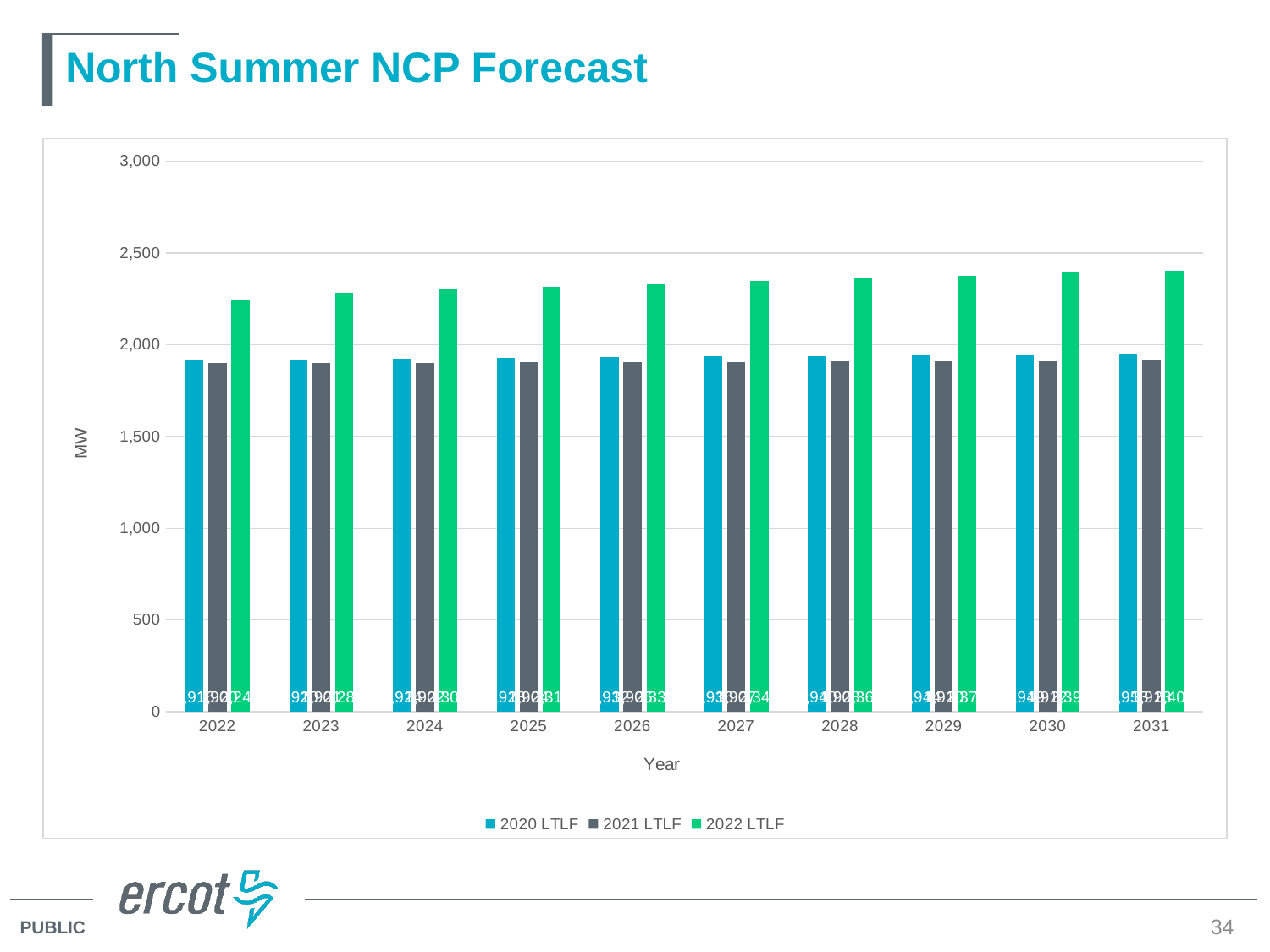
Which series has the lowest value in 2022? 2021 LTLF Is the 2022 LTLF value for 2022 greater or less than 2,000? greater Which series has the highest value in 2031? 2022 LTLF What is the label on the y axis? MW What kind of chart is shown on the slide? bar chart In which year is the 2022 LTLF value highest? 2031 Do the 2022 LTLF values rise or fall from 2022 to 2031? rise Is the 2022 LTLF value for 2031 greater or less than 2,500? less How many years are shown on the x axis? 10 How many series does the legend list? 3 Is the 2020 LTLF value for 2031 greater or less than 2,000? less Which is larger in 2026, the 2022 LTLF value or the 2021 LTLF value? 2022 LTLF